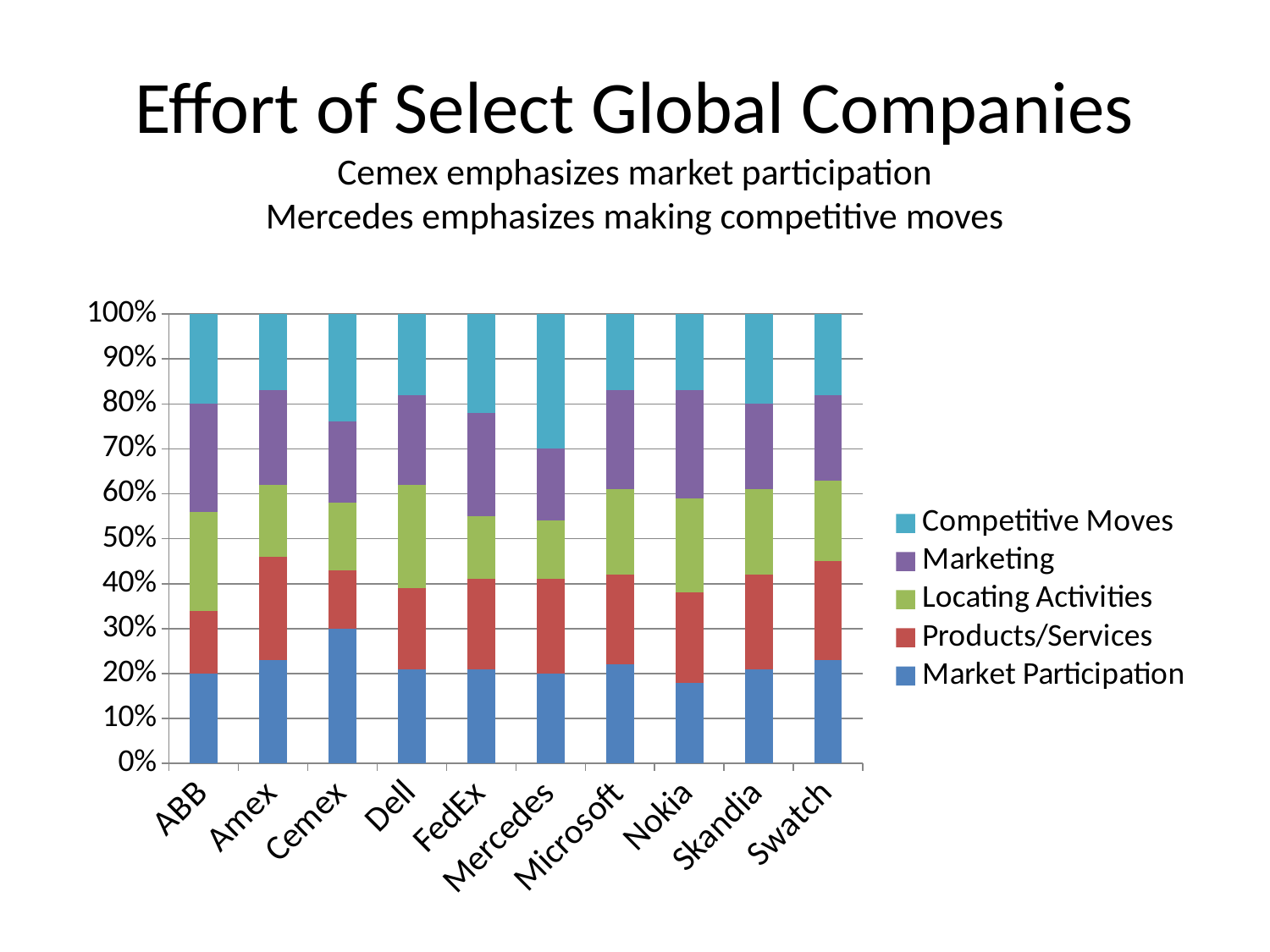
What is the total of the stacked bar for Swatch? 100% Is the Competitive Moves segment for Mercedes greater or less than 20%? greater Which company has the largest Competitive Moves segment? Mercedes Is the Market Participation segment for ABB greater or less than 30%? less Is the Market Participation segment for Cemex greater or less than 25%? greater Which company has the largest Market Participation segment? Cemex What is the title of the slide containing the chart? Effort of Select Global Companies What kind of chart is shown on the slide? Stacked bar chart How many series does the chart's legend list? 5 Which series is plotted at the bottom of each stacked bar? Market Participation How many companies are shown on the x axis of the chart? 10 Which is larger, the Market Participation segment for Cemex or for Dell? Cemex